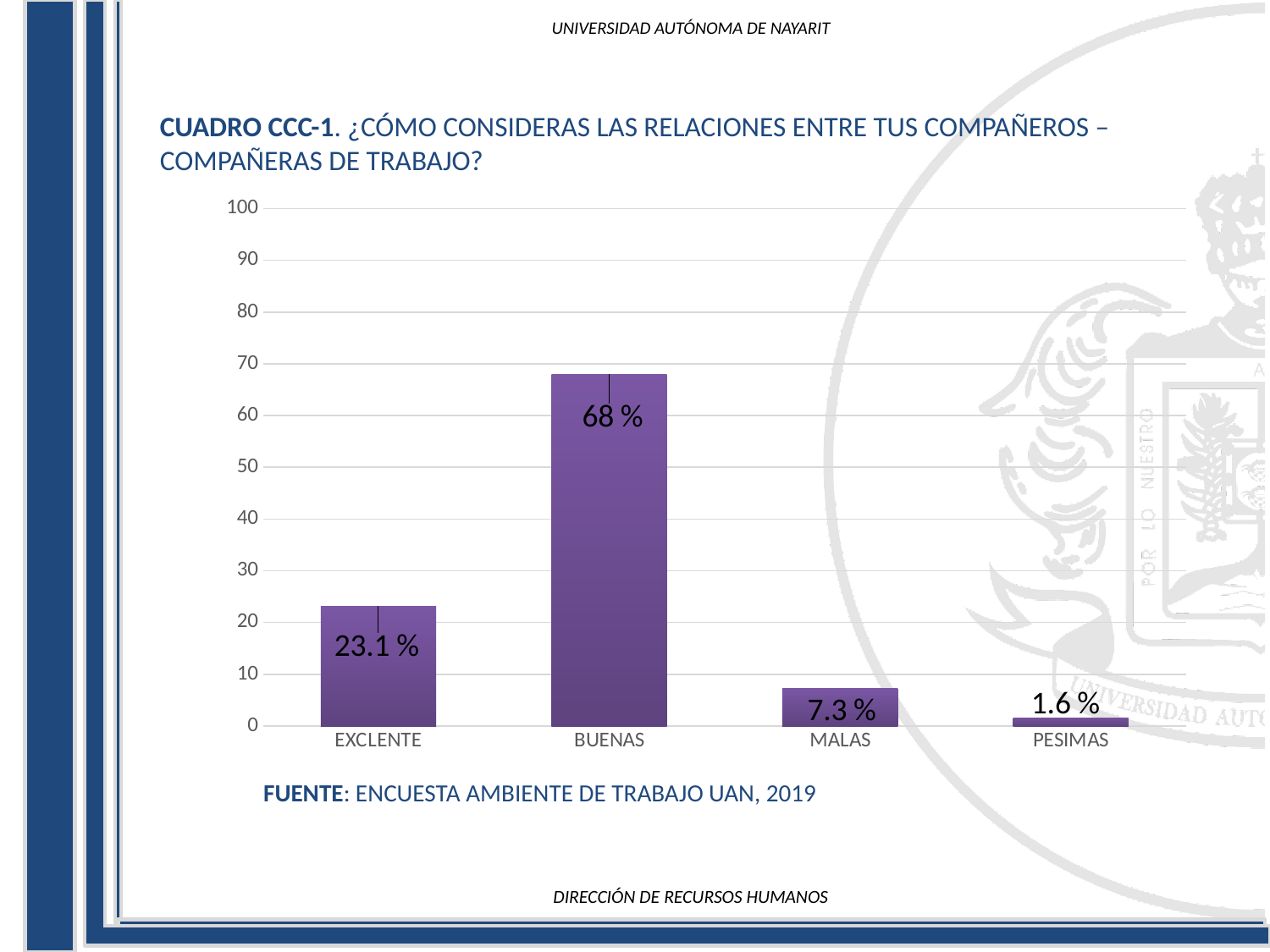
What is the difference between the values for BUENAS and EXCLENTE? 44.9 % What kind of chart is shown on the slide? Bar chart What is the value for EXCLENTE? 23.1 % What source is cited below the chart? ENCUESTA AMBIENTE DE TRABAJO UAN, 2019 Which category has the lowest value? PESIMAS What is the value for BUENAS? 68 % What is the value for PESIMAS? 1.6 % What is the value for MALAS? 7.3 % Which is larger, the value for MALAS or the value for PESIMAS? MALAS Which category has the highest value? BUENAS How many categories are shown on the x axis? 4 Is the value for BUENAS greater or less than 60? greater